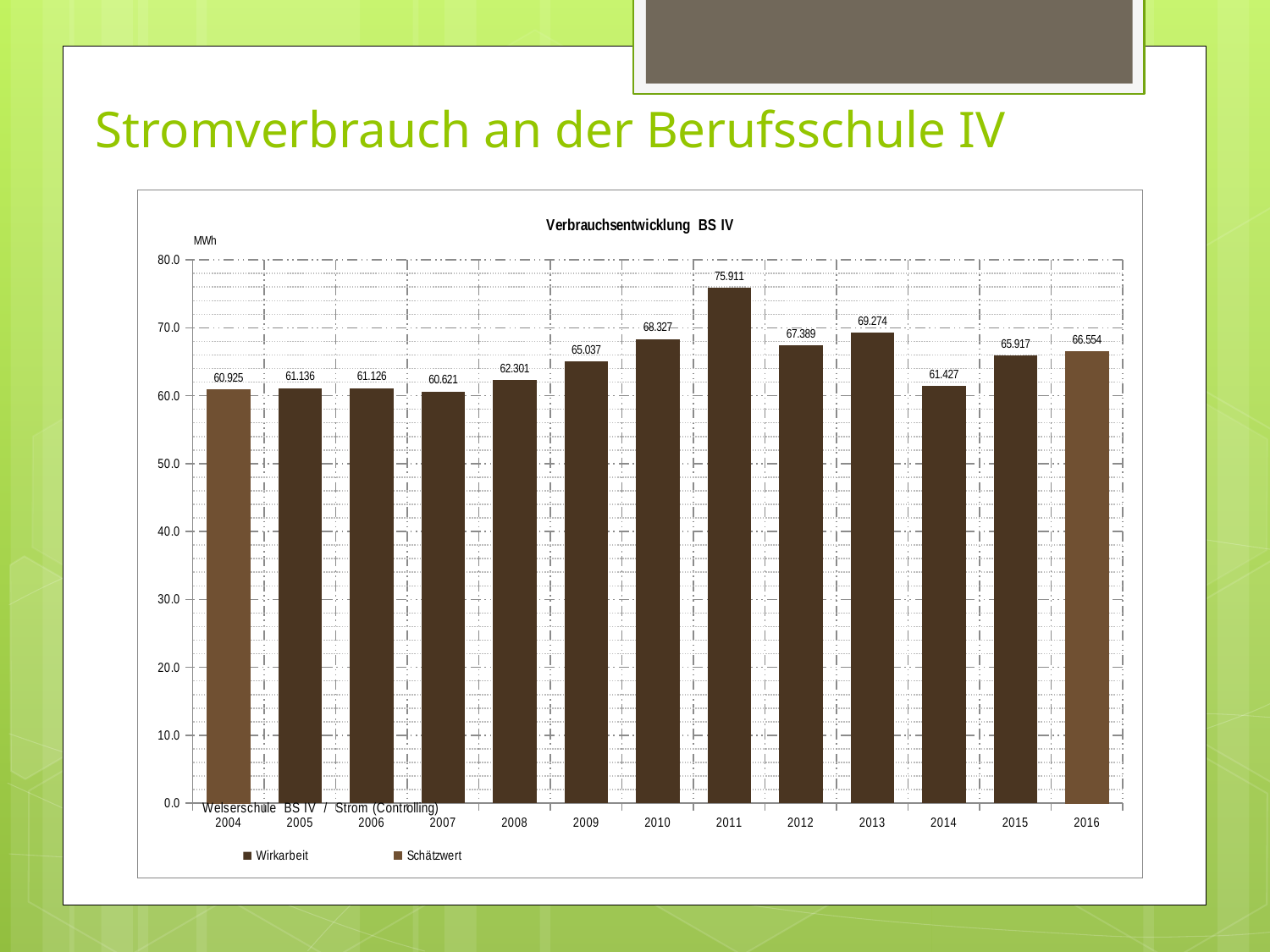
How many years are shown on the x axis of the Verbrauchsentwicklung BS IV chart? 13 How many series does the legend of the Verbrauchsentwicklung BS IV chart list? 2 What is the value for 2016 in the Verbrauchsentwicklung BS IV chart? 66.554 Is the value for 2014 in the Verbrauchsentwicklung BS IV chart greater or less than 70.0? less What kind of chart is the Verbrauchsentwicklung BS IV chart? bar chart What is the value for 2008 in the Verbrauchsentwicklung BS IV chart? 62.301 Which year has the highest value in the Verbrauchsentwicklung BS IV chart? 2011 What is the difference between the values for 2011 and 2007 in the Verbrauchsentwicklung BS IV chart? 15.290 Which year has the lowest value in the Verbrauchsentwicklung BS IV chart? 2007 What is the difference between the values for 2013 and 2012 in the Verbrauchsentwicklung BS IV chart? 1.885 What is the value for 2011 in the Verbrauchsentwicklung BS IV chart? 75.911 Which is larger in the Verbrauchsentwicklung BS IV chart, the value for 2010 or the value for 2012? 2010